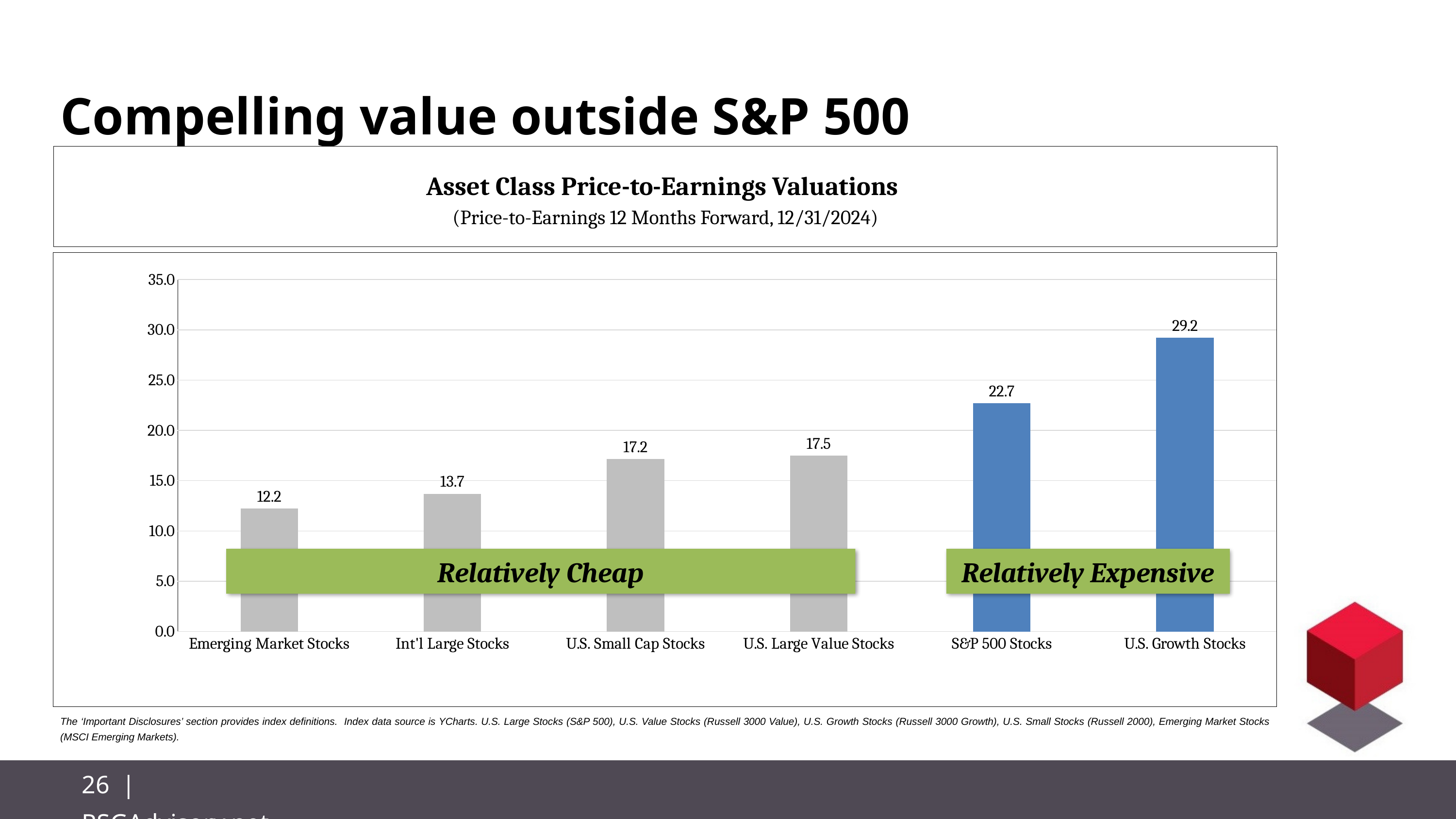
What is the difference between the price-to-earnings values of U.S. Growth Stocks and S&P 500 Stocks? 6.5 What is the price-to-earnings value for U.S. Large Value Stocks? 17.5 What is the price-to-earnings value for Emerging Market Stocks? 12.2 What is the difference between the price-to-earnings values of Int'l Large Stocks and Emerging Market Stocks? 1.5 What is the price-to-earnings value for S&P 500 Stocks? 22.7 Which asset class has the lowest price-to-earnings valuation? Emerging Market Stocks How many asset classes are shown in the chart? 6 What kind of chart is shown on the slide? bar chart Which has a higher price-to-earnings value, U.S. Small Cap Stocks or Int'l Large Stocks? U.S. Small Cap Stocks Which asset class has the highest price-to-earnings valuation? U.S. Growth Stocks What is the title of the chart? Asset Class Price-to-Earnings Valuations Is the value for S&P 500 Stocks greater or less than 20.0? greater